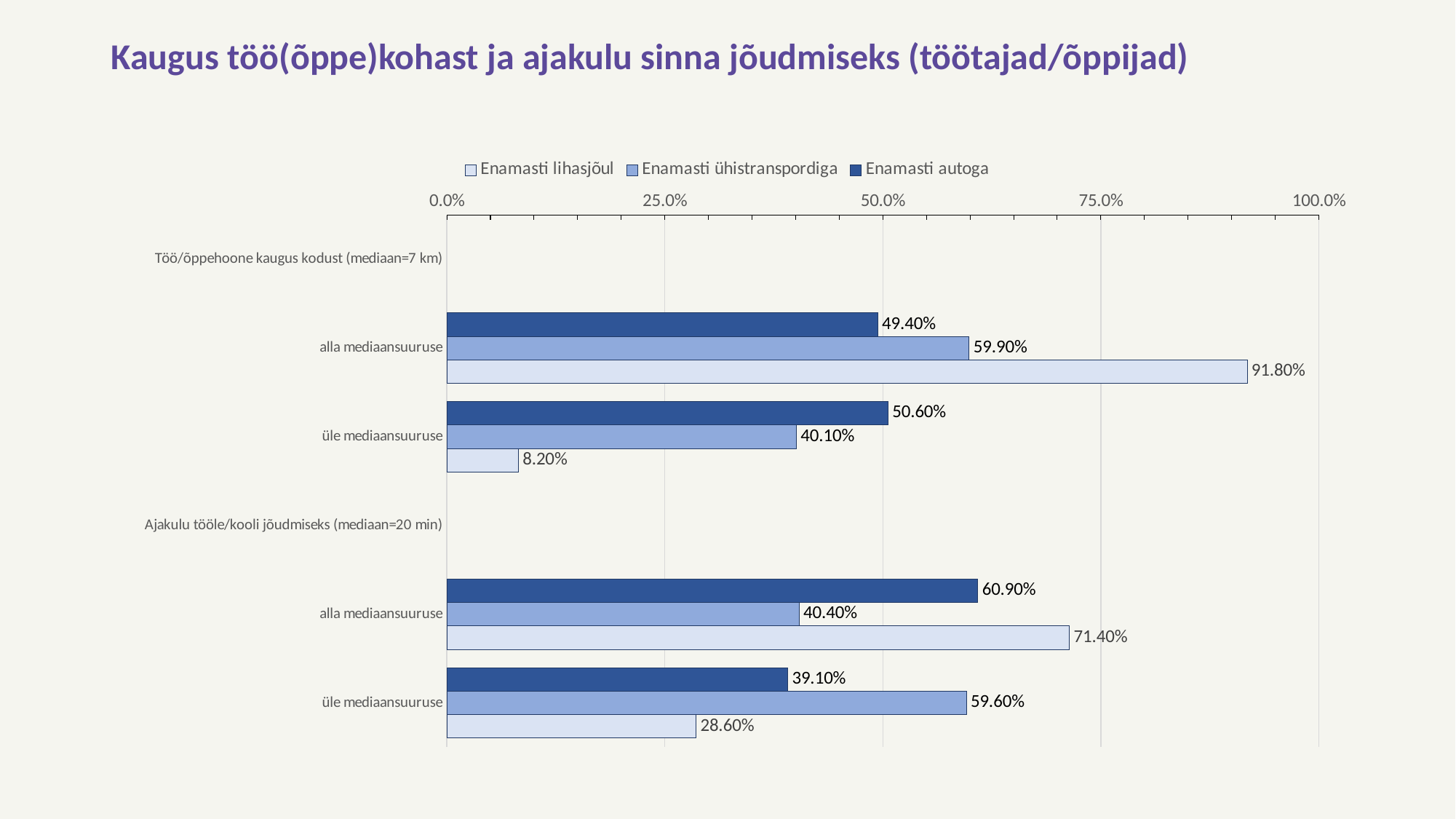
Which series has the highest value for 'alla mediaansuuruse' under 'Ajakulu tööle/kooli jõudmiseks (mediaan=20 min)'? Enamasti lihasjõul What is the value for 'Enamasti ühistranspordiga' for 'üle mediaansuuruse' under 'Ajakulu tööle/kooli jõudmiseks (mediaan=20 min)'? 59.60% What is the value for 'Enamasti lihasjõul' for 'alla mediaansuuruse' under 'Ajakulu tööle/kooli jõudmiseks (mediaan=20 min)'? 71.40% Which is larger for 'üle mediaansuuruse' under 'Ajakulu tööle/kooli jõudmiseks (mediaan=20 min)': 'Enamasti autoga' or 'Enamasti ühistranspordiga'? Enamasti ühistranspordiga Which series has the lowest value for 'üle mediaansuuruse' under 'Töö/õppehoone kaugus kodust (mediaan=7 km)'? Enamasti lihasjõul What is the value for 'Enamasti lihasjõul' for 'alla mediaansuuruse' under 'Töö/õppehoone kaugus kodust (mediaan=7 km)'? 91.80% What is the difference between the 'Enamasti lihasjõul' values for 'alla mediaansuuruse' and 'üle mediaansuuruse' under 'Töö/õppehoone kaugus kodust (mediaan=7 km)'? 83.60% What is the title of the chart on the slide? Kaugus töö(õppe)kohast ja ajakulu sinna jõudmiseks (töötajad/õppijad) What kind of chart is shown on the slide? bar chart How many series does the legend list? 3 What is the difference between 'Enamasti autoga' and 'Enamasti ühistranspordiga' for 'alla mediaansuuruse' under 'Ajakulu tööle/kooli jõudmiseks (mediaan=20 min)'? 20.50% What is the value for 'Enamasti autoga' for 'üle mediaansuuruse' under 'Töö/õppehoone kaugus kodust (mediaan=7 km)'? 50.60%